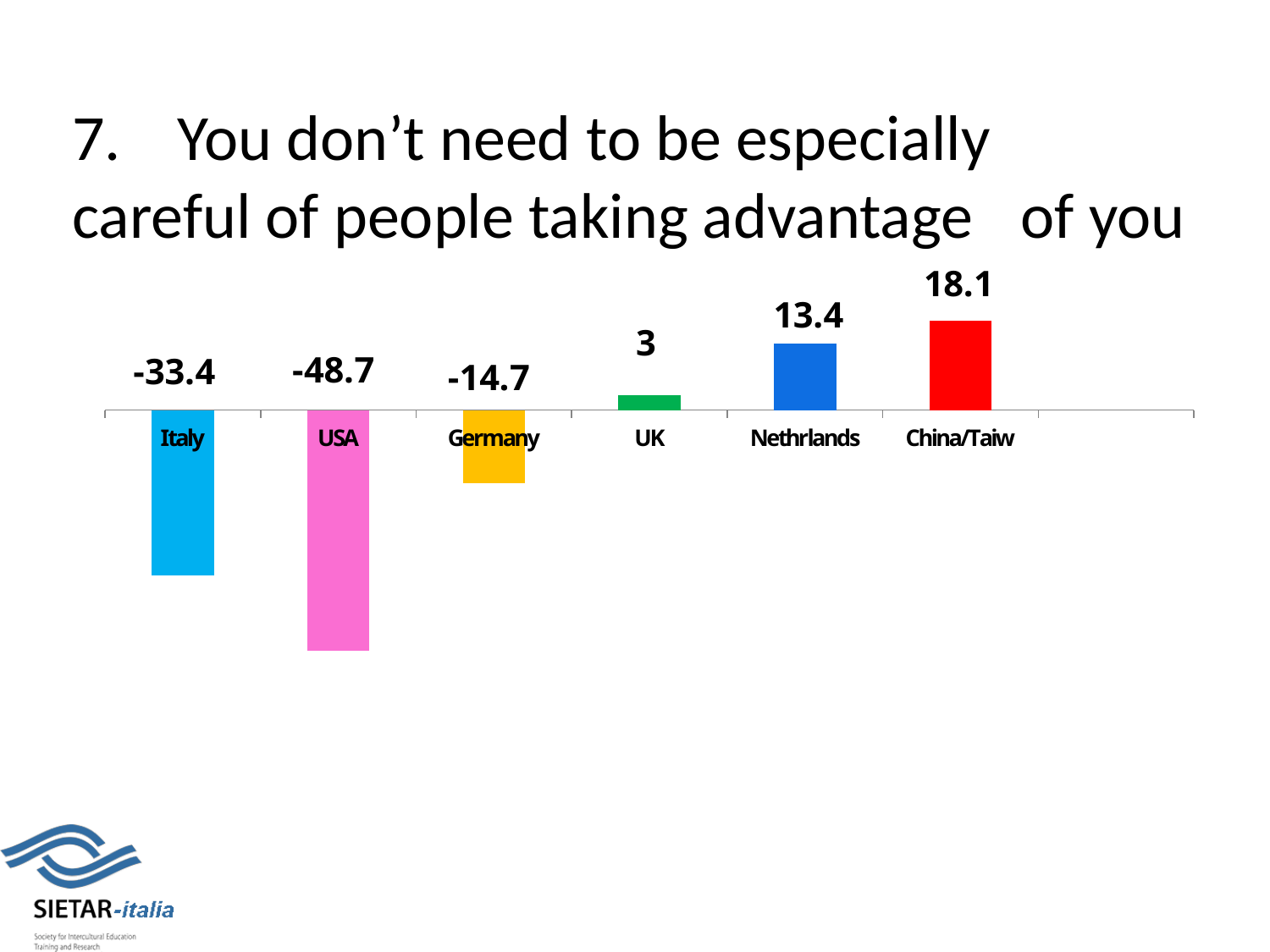
What is the value for Italy? -33.4 What is the value for the UK? 3 What kind of chart is shown on the slide? bar chart How many categories are shown in the chart? 6 Which category has the highest value? China/Taiw What is the value for Nethrlands? 13.4 What is the value for USA? -48.7 What is the value for Germany? -14.7 What colour is the bar for USA? pink What is the difference between the values for China/Taiw and Nethrlands? 4.7 Which has the larger value, Italy or Germany? Germany Which category has the lowest value? USA